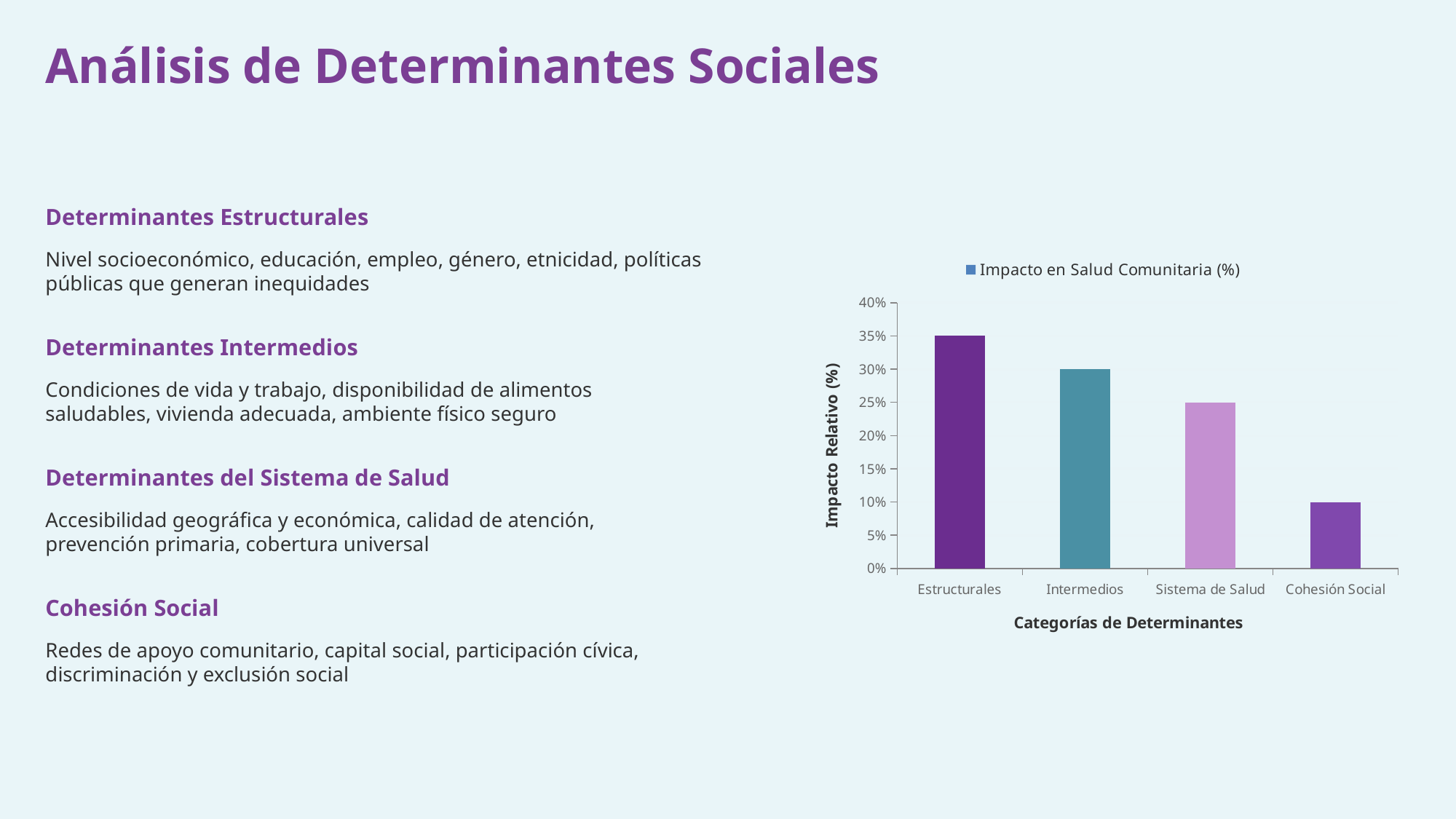
Do the values rise or fall from left to right along the x axis? fall Is the value for Sistema de Salud greater or less than 20%? greater What is the value for Cohesión Social in the chart? 10% What is the value for Estructurales in the chart? 35% Which category has the highest value in the chart? Estructurales How many categories are shown on the x axis of the chart? 4 What kind of chart is shown on the slide? bar chart What is the value for Intermedios in the chart? 30% What series name does the chart legend show? Impacto en Salud Comunitaria (%) Which category has the lowest value in the chart? Cohesión Social Which is larger, the value for Intermedios or the value for Sistema de Salud? Intermedios What is the difference between the values for Estructurales and Cohesión Social? 25%